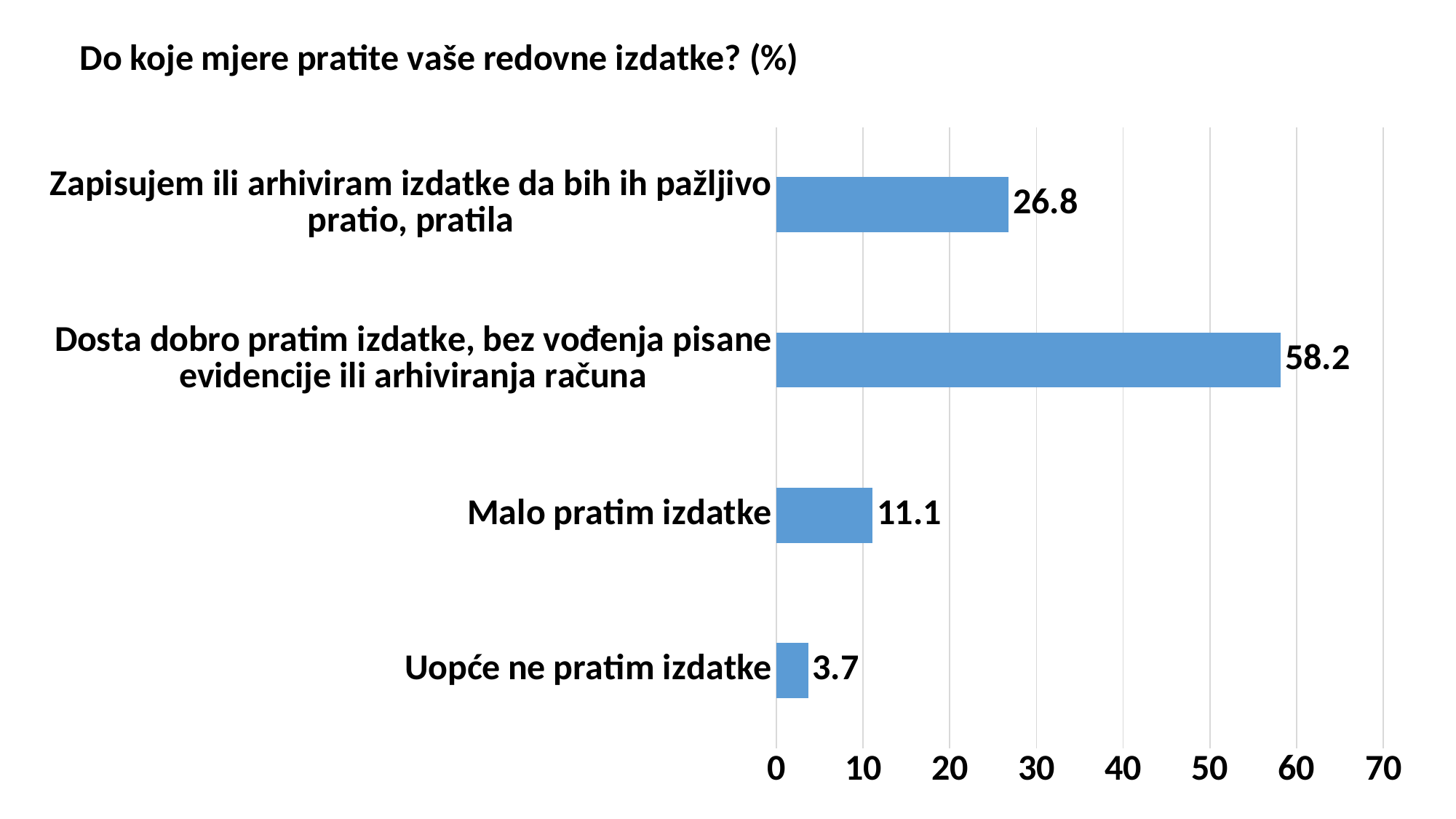
What is the value for "Uopće ne pratim izdatke"? 3.7 Which is larger: the value for "Malo pratim izdatke" or the value for "Zapisujem ili arhiviram izdatke da bih ih pažljivo pratio, pratila"? Zapisujem ili arhiviram izdatke da bih ih pažljivo pratio, pratila What is the difference between the values for "Malo pratim izdatke" and "Uopće ne pratim izdatke"? 7.4 How many categories are shown in the chart? 4 What kind of chart is shown on the slide? bar chart What is the title of the chart? Do koje mjere pratite vaše redovne izdatke? (%) Which category has the lowest value? Uopće ne pratim izdatke Which category has the highest value? Dosta dobro pratim izdatke, bez vođenja pisane evidencije ili arhiviranja računa What is the value for "Zapisujem ili arhiviram izdatke da bih ih pažljivo pratio, pratila"? 26.8 What is the difference between the values for "Dosta dobro pratim izdatke, bez vođenja pisane evidencije ili arhiviranja računa" and "Zapisujem ili arhiviram izdatke da bih ih pažljivo pratio, pratila"? 31.4 What is the value for "Malo pratim izdatke"? 11.1 Is the value for "Dosta dobro pratim izdatke, bez vođenja pisane evidencije ili arhiviranja računa" greater or less than 50? greater